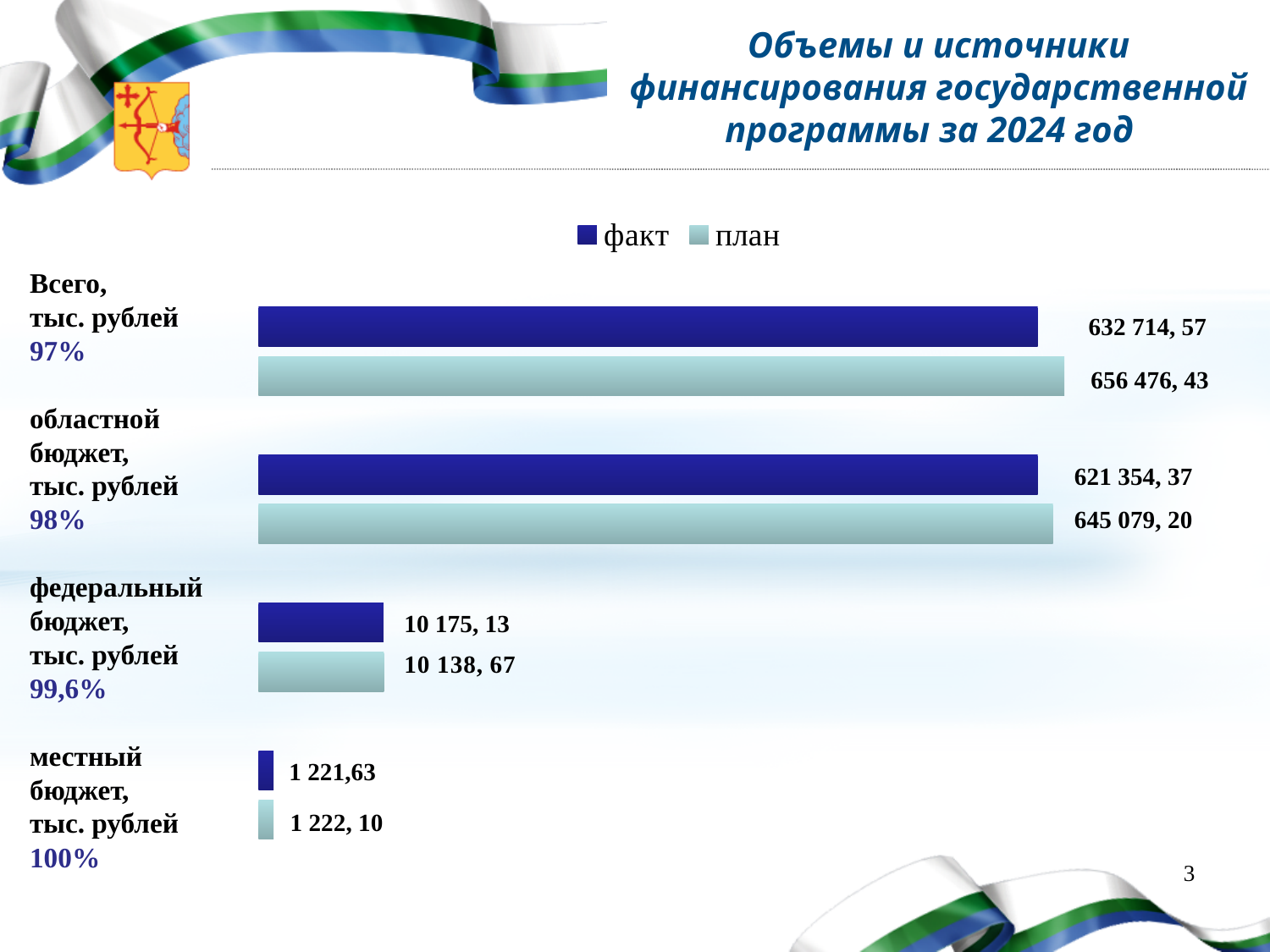
What is the факт value for федеральный бюджет, тыс. рублей? 10 175, 13 What is the difference between the факт and план values for федеральный бюджет, тыс. рублей? 36,46 What is the план value for местный бюджет, тыс. рублей? 1 222, 10 What is the difference between the план and факт values for Всего, тыс. рублей? 23 761,86 What is the план value for областной бюджет, тыс. рублей? 645 079, 20 What kind of chart is shown on the slide? bar chart How many categories are shown in the chart? 4 What is the факт value for Всего, тыс. рублей? 632 714, 57 For Всего, тыс. рублей, which is larger: факт or план? план Which category has the lowest факт value? местный бюджет, тыс. рублей How many series does the legend list? 2 Which category has the highest план value? Всего, тыс. рублей